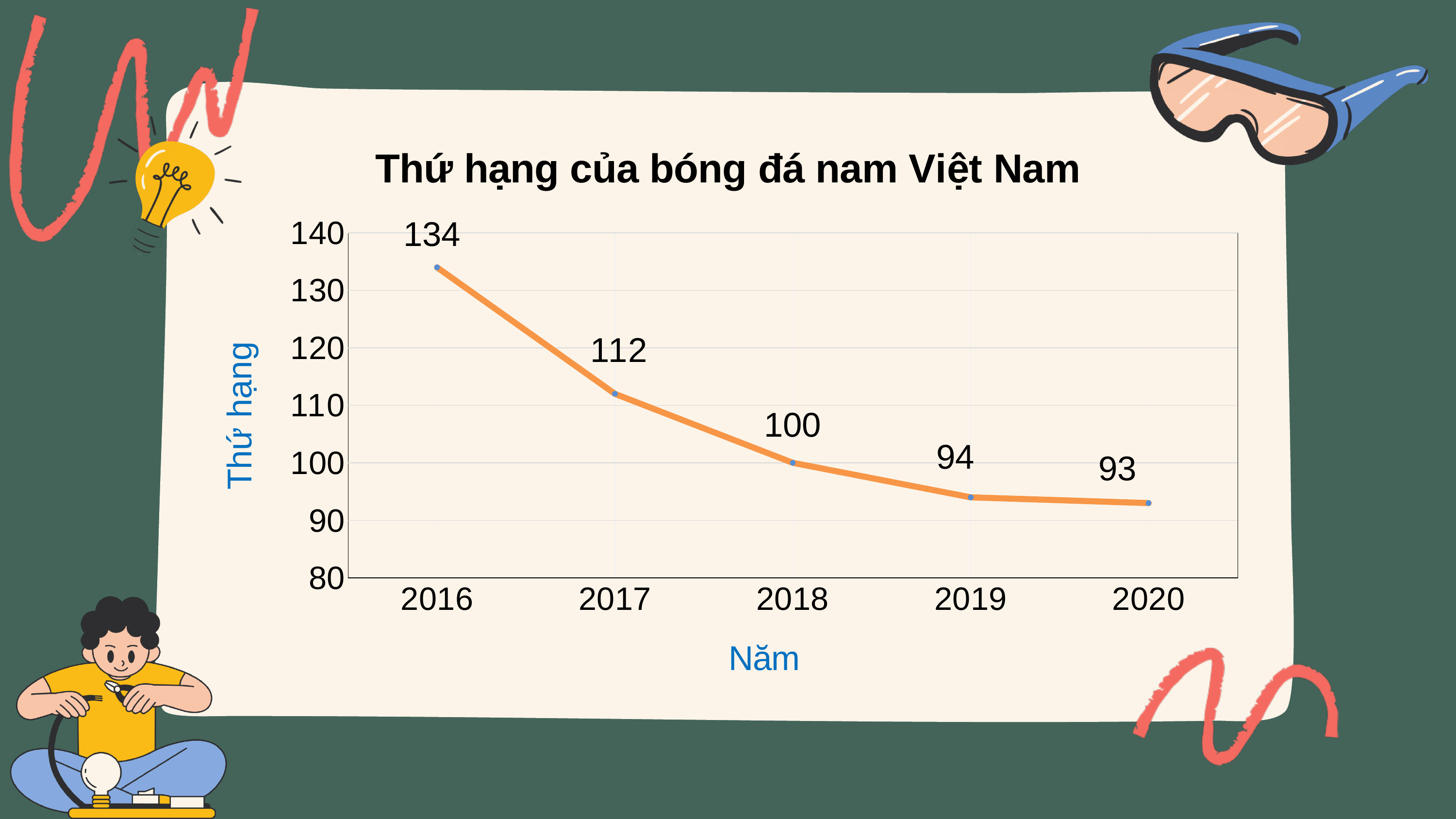
Which year has the larger value, 2017 or 2019? 2017 What is the ranking value shown for 2020? 93 Is the value for 2017 greater or less than 110? greater What is the difference between the values for 2016 and 2017? 22 How many years are plotted on the chart? 5 What kind of chart is shown on the slide? line chart What is the difference between the values for 2018 and 2019? 6 What is the ranking value shown for 2016? 134 Which year has the lowest value on the chart? 2020 Do the values rise or fall from 2016 to 2020? fall What is the ranking value shown for 2018? 100 Which year has the highest value on the chart? 2016